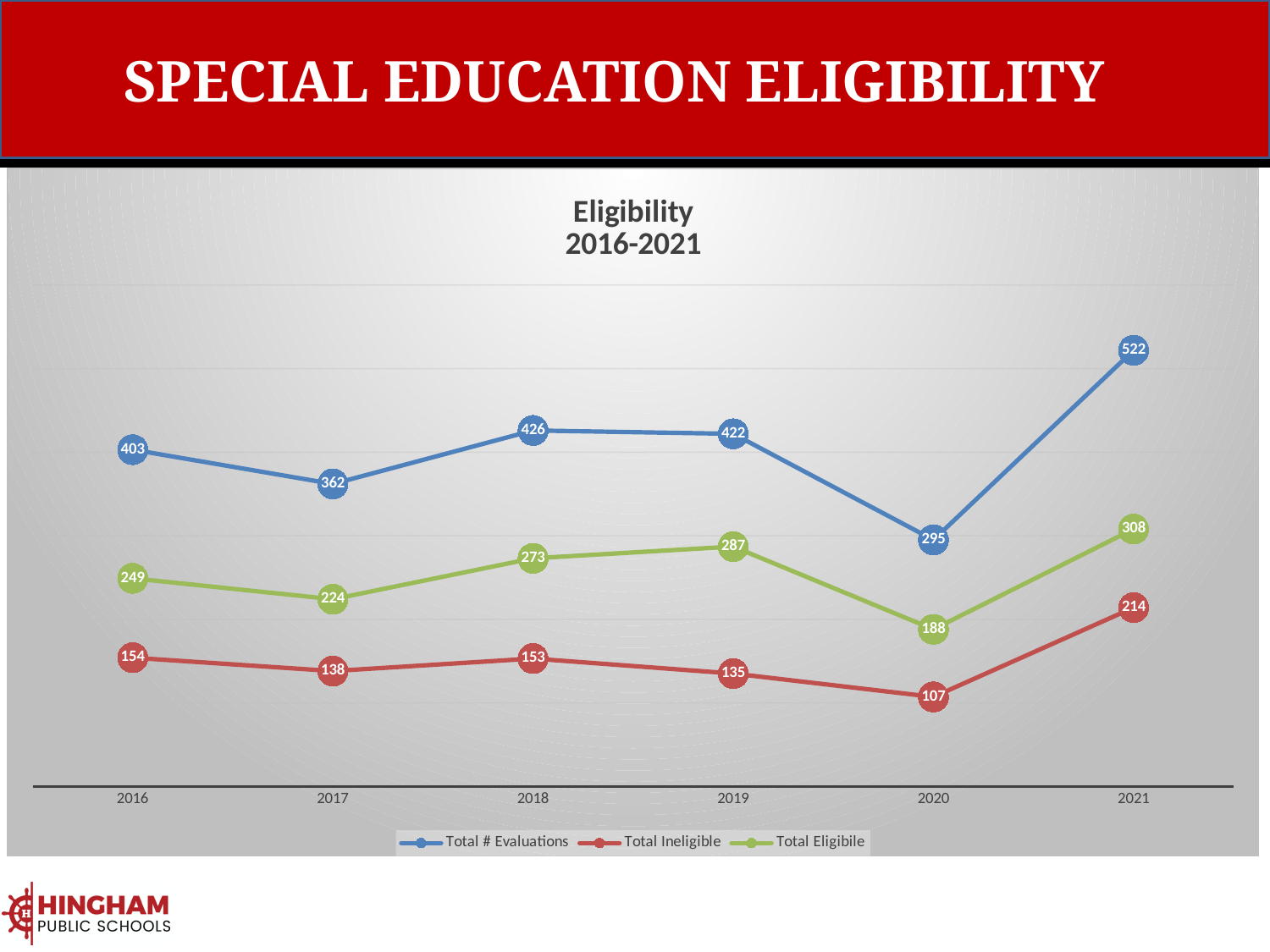
Does Total Ineligible rise or fall from 2019 to 2020? Fall What is the Total # Evaluations value for 2021? 522 What is the title of the chart? Eligibility 2016-2021 In which year is Total Eligibile highest? 2021 What is the difference between Total # Evaluations and Total Eligibile in 2016? 154 What is the Total Ineligible value for 2018? 153 What is the Total Eligibile value for 2020? 188 Which is larger in 2019: Total Eligibile or Total Ineligible? Total Eligibile In which year is Total # Evaluations lowest? 2020 What kind of chart is this? Line chart How many series does the legend list? 3 How many years are shown on the x axis? 6